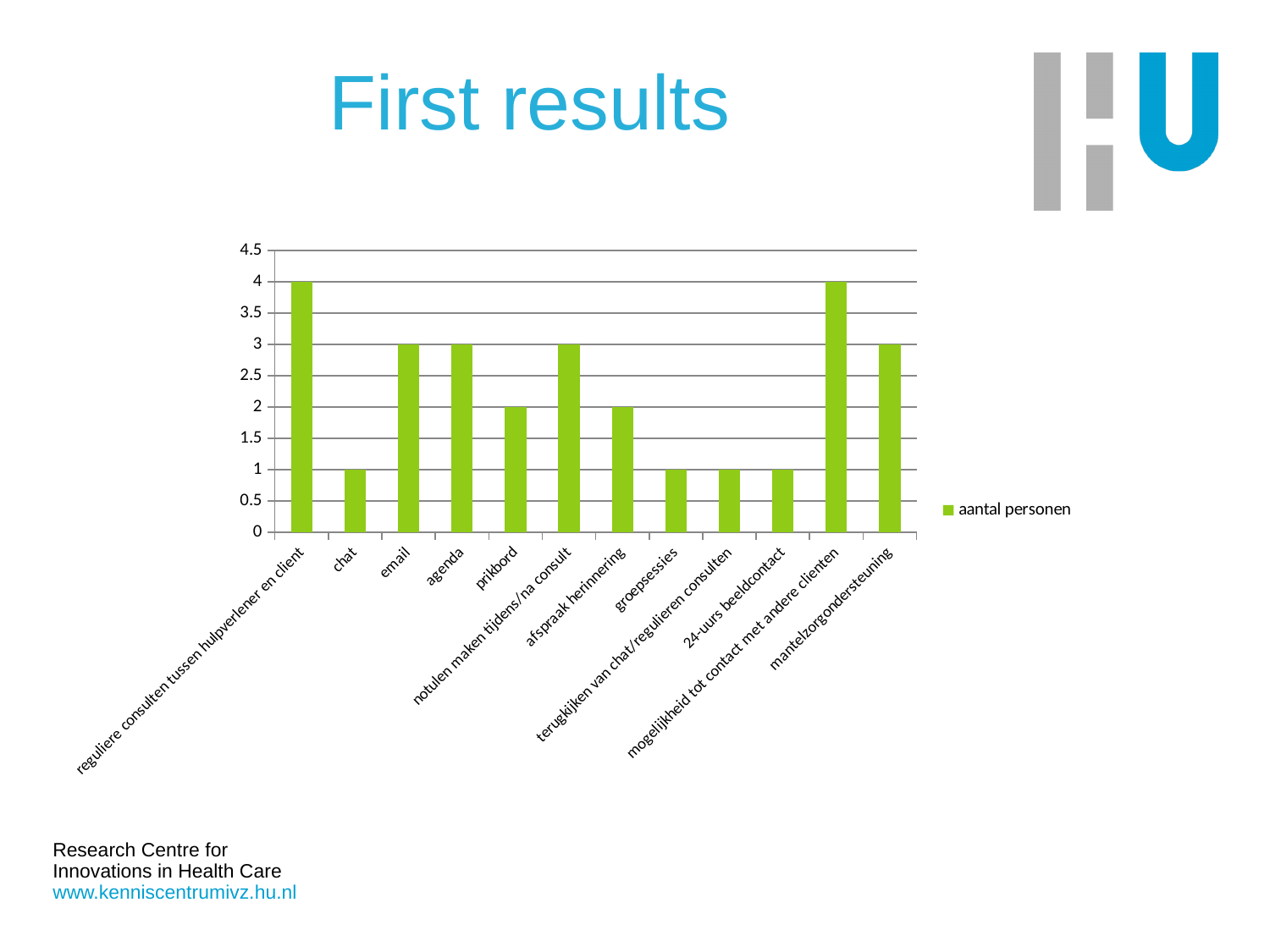
What is the value for 'mogelijkheid tot contact met andere clienten'? 4 Is the value for '24-uurs beeldcontact' greater or less than 2? less What is the difference between the value for 'reguliere consulten tussen hulpverlener en client' and the value for 'afspraak herinnering'? 2 Which is larger, the value for 'agenda' or the value for 'groepsessies'? agenda What is the value for 'chat'? 1 What is the value for 'mantelzorgondersteuning'? 3 How many series does the legend list? 1 What is the value for 'prikbord'? 2 How many categories are shown on the x axis of the chart? 12 What is the value for 'email'? 3 What kind of chart is shown on the slide? bar chart What is the name of the series shown in the legend? aantal personen